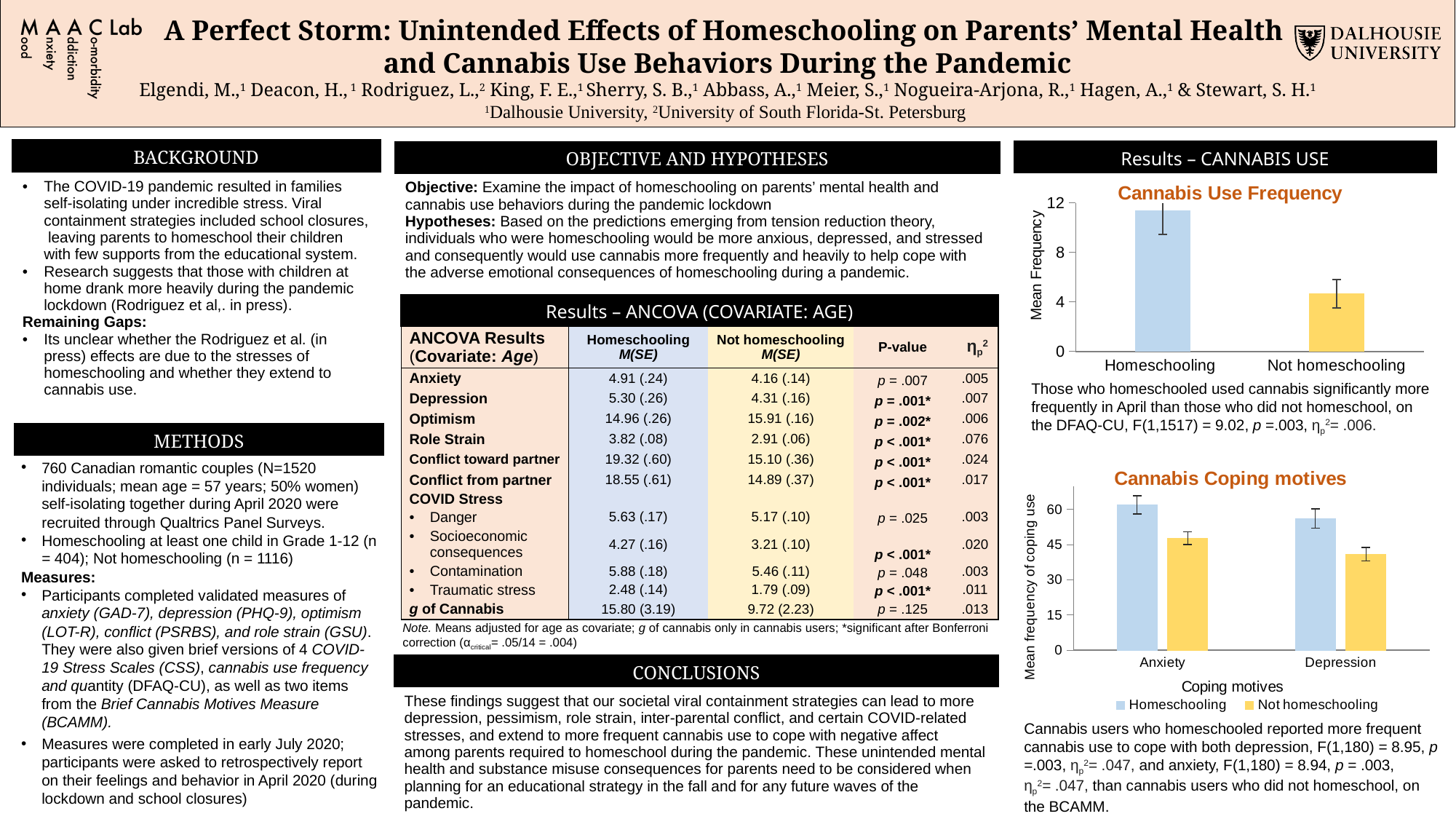
In the Cannabis Coping motives chart, for Depression, which group has the larger value: Homeschooling or Not homeschooling? Homeschooling In the Cannabis Use Frequency chart, which group has the higher mean frequency? Homeschooling What type of chart is the Cannabis Use Frequency chart? Bar chart In the Cannabis Use Frequency chart, how many categories are shown on the x axis? 2 In the Cannabis Coping motives chart, is the Homeschooling value for Depression greater or less than 45? greater In the Cannabis Coping motives chart, which coping motive has the highest Homeschooling bar? Anxiety What is the y-axis label of the Cannabis Use Frequency chart? Mean Frequency In the Cannabis Coping motives chart, what is the x-axis title? Coping motives In the Cannabis Coping motives chart, how many series does the legend list? 2 In the Cannabis Use Frequency chart, is the value for Homeschooling greater or less than 8? greater In the Cannabis Use Frequency chart, is the value for Not homeschooling greater or less than 8? less